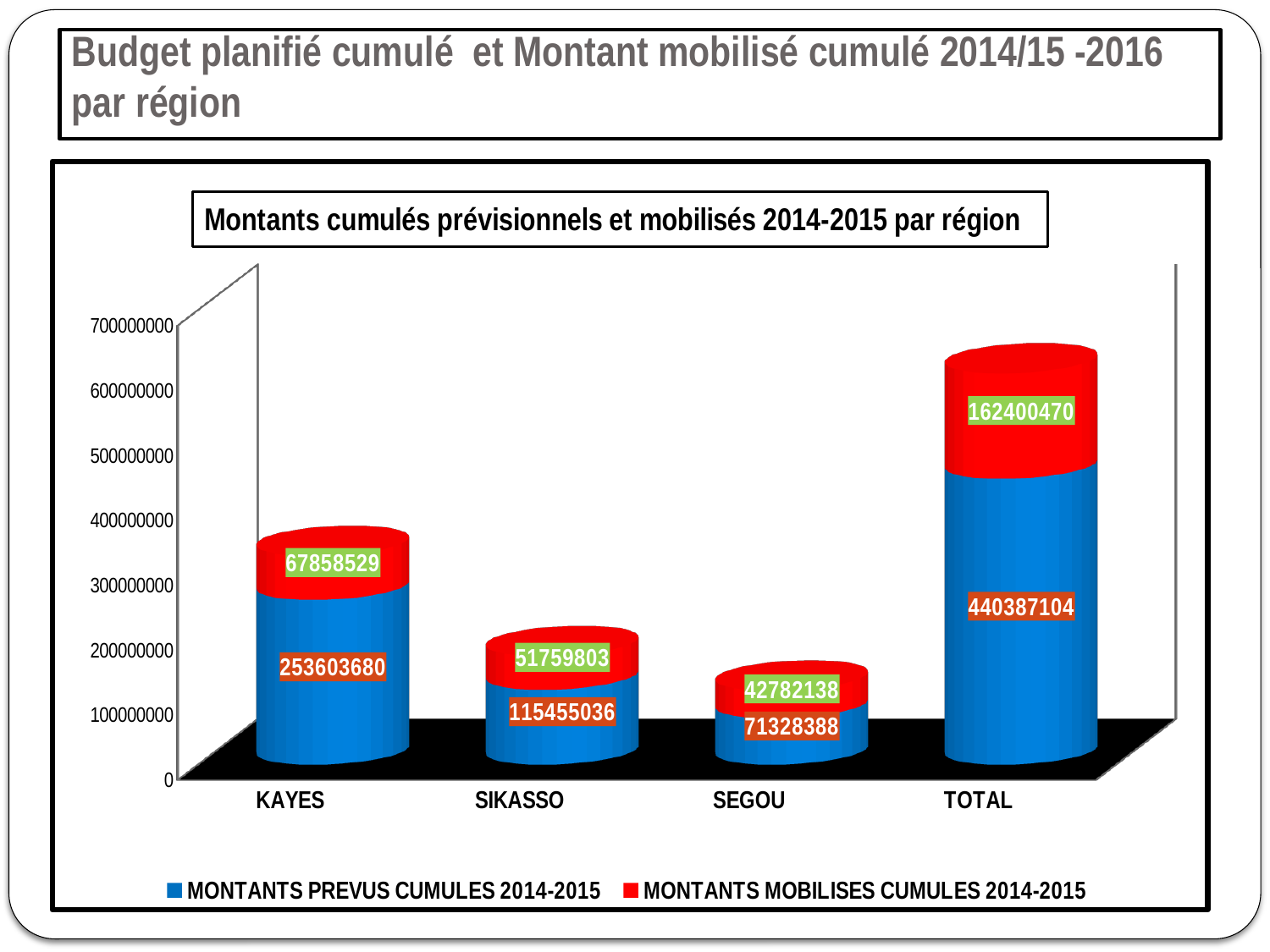
Which is larger: MONTANTS MOBILISES CUMULES 2014-2015 for KAYES or for SIKASSO? KAYES What is the total of the stacked bar for SIKASSO? 167214839 How many series does the legend list? 2 What kind of chart is shown on the slide? Stacked bar chart Among the regions KAYES, SIKASSO and SEGOU, which has the highest MONTANTS PREVUS CUMULES 2014-2015? KAYES What is the total of the stacked bar for SEGOU? 114110526 What is the value of MONTANTS MOBILISES CUMULES 2014-2015 for TOTAL? 162400470 What is the value of MONTANTS MOBILISES CUMULES 2014-2015 for SIKASSO? 51759803 Among the regions KAYES, SIKASSO and SEGOU, which has the lowest MONTANTS MOBILISES CUMULES 2014-2015? SEGOU What is the value of MONTANTS PREVUS CUMULES 2014-2015 for KAYES? 253603680 What is the value of MONTANTS PREVUS CUMULES 2014-2015 for SEGOU? 71328388 What is the difference between MONTANTS PREVUS CUMULES 2014-2015 and MONTANTS MOBILISES CUMULES 2014-2015 for KAYES? 185745151